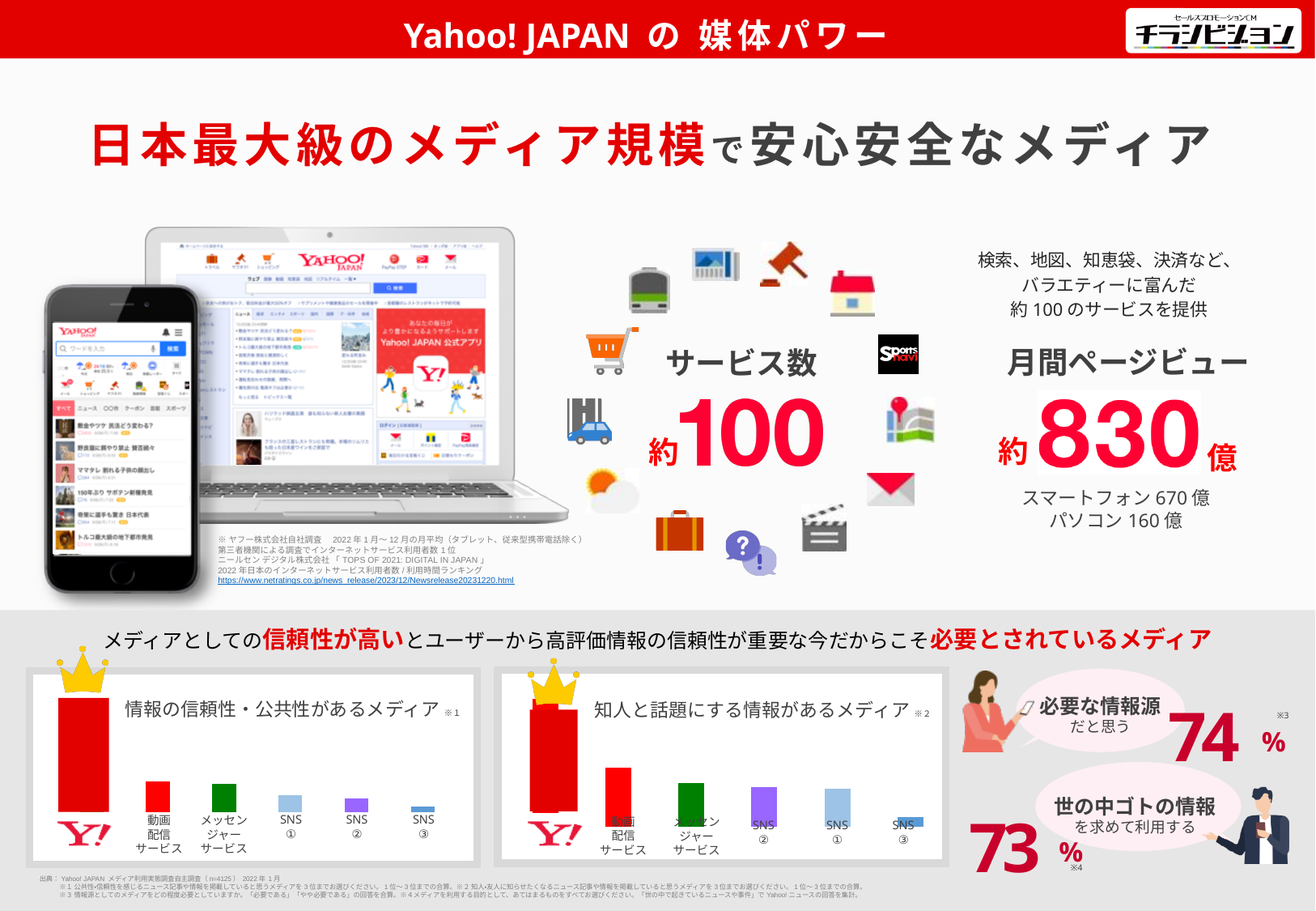
In the chart titled 情報の信頼性・公共性があるメディア, which category has the lowest bar? SNS③ In the chart titled 情報の信頼性・公共性があるメディア, which is larger: メッセンジャーサービス or SNS①? メッセンジャーサービス What kind of chart is the left chart titled 情報の信頼性・公共性があるメディア? bar chart In the chart titled 知人と話題にする情報があるメディア, which category has the highest bar? Y! (Yahoo! JAPAN) In the chart titled 情報の信頼性・公共性があるメディア, how many categories (bars) are shown? 6 In the chart titled 知人と話題にする情報があるメディア, which category has the lowest bar? SNS③ In the chart titled 情報の信頼性・公共性があるメディア, what colour is the bar for メッセンジャーサービス? green In the chart titled 情報の信頼性・公共性があるメディア, which category has the highest bar? Y! (Yahoo! JAPAN) What is the title of the right-hand bar chart at the bottom of the slide? 知人と話題にする情報があるメディア What kind of chart is the right chart titled 知人と話題にする情報があるメディア? bar chart In the chart titled 知人と話題にする情報があるメディア, which is larger: 動画配信サービス or メッセンジャーサービス? 動画配信サービス In the chart titled 知人と話題にする情報があるメディア, how many categories (bars) are shown? 6